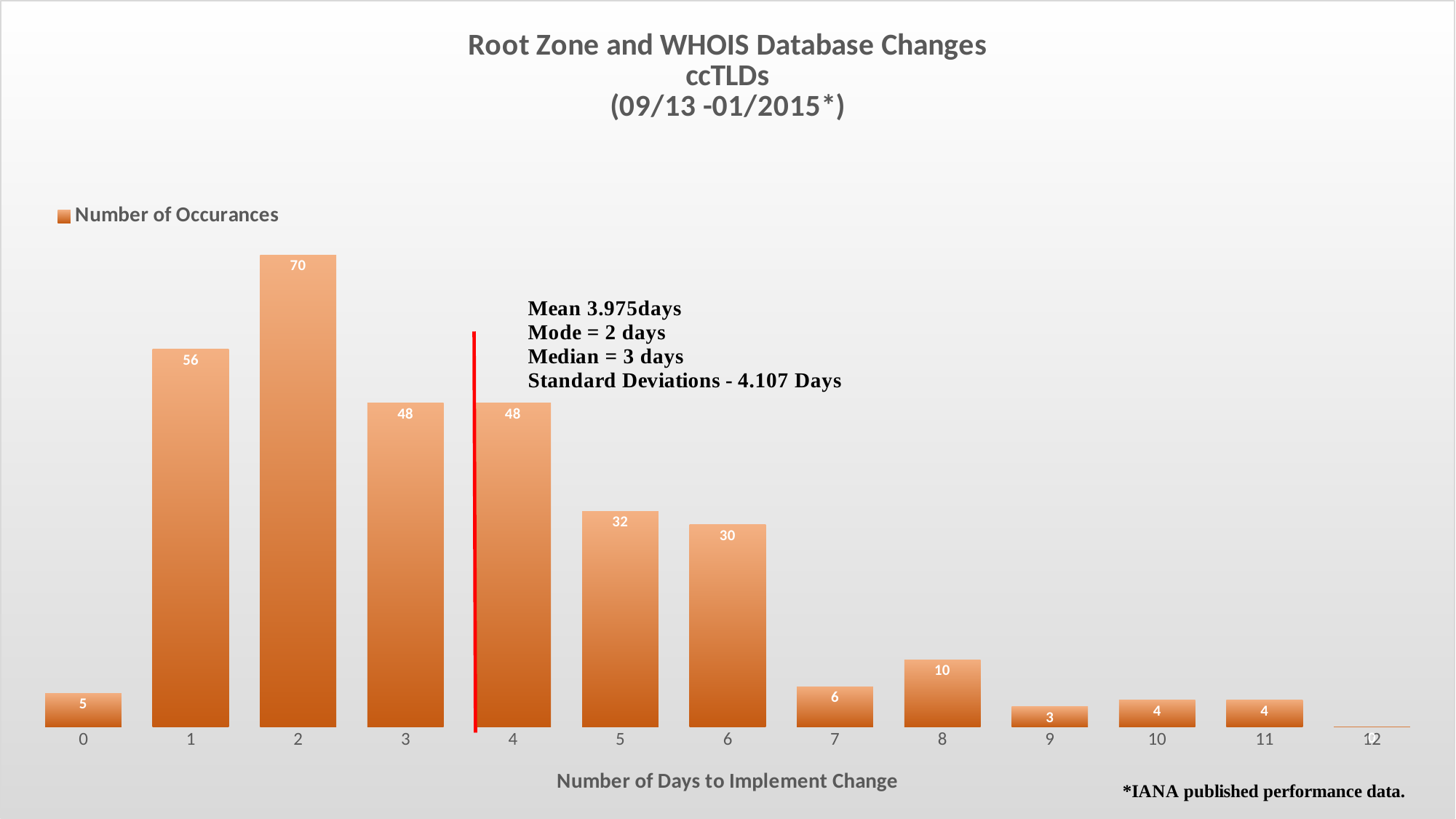
What is the difference in occurrences between 1 day and 3 days to implement change? 8 What is the difference in occurrences between 2 days and 6 days to implement change? 40 Which has more occurrences: 7 days or 8 days to implement change? 8 days What kind of chart is shown on the slide? Bar chart What is the x-axis title of the chart? Number of Days to Implement Change What is the number of occurrences for 8 days to implement change? 10 How many series does the legend list? 1 What is the number of occurrences for 5 days to implement change? 32 Which has more occurrences: 0 days or 9 days to implement change? 0 days How many categories are shown on the x axis? 13 Which number of days to implement change has the highest number of occurrences? 2 What is the number of occurrences for 2 days to implement change? 70